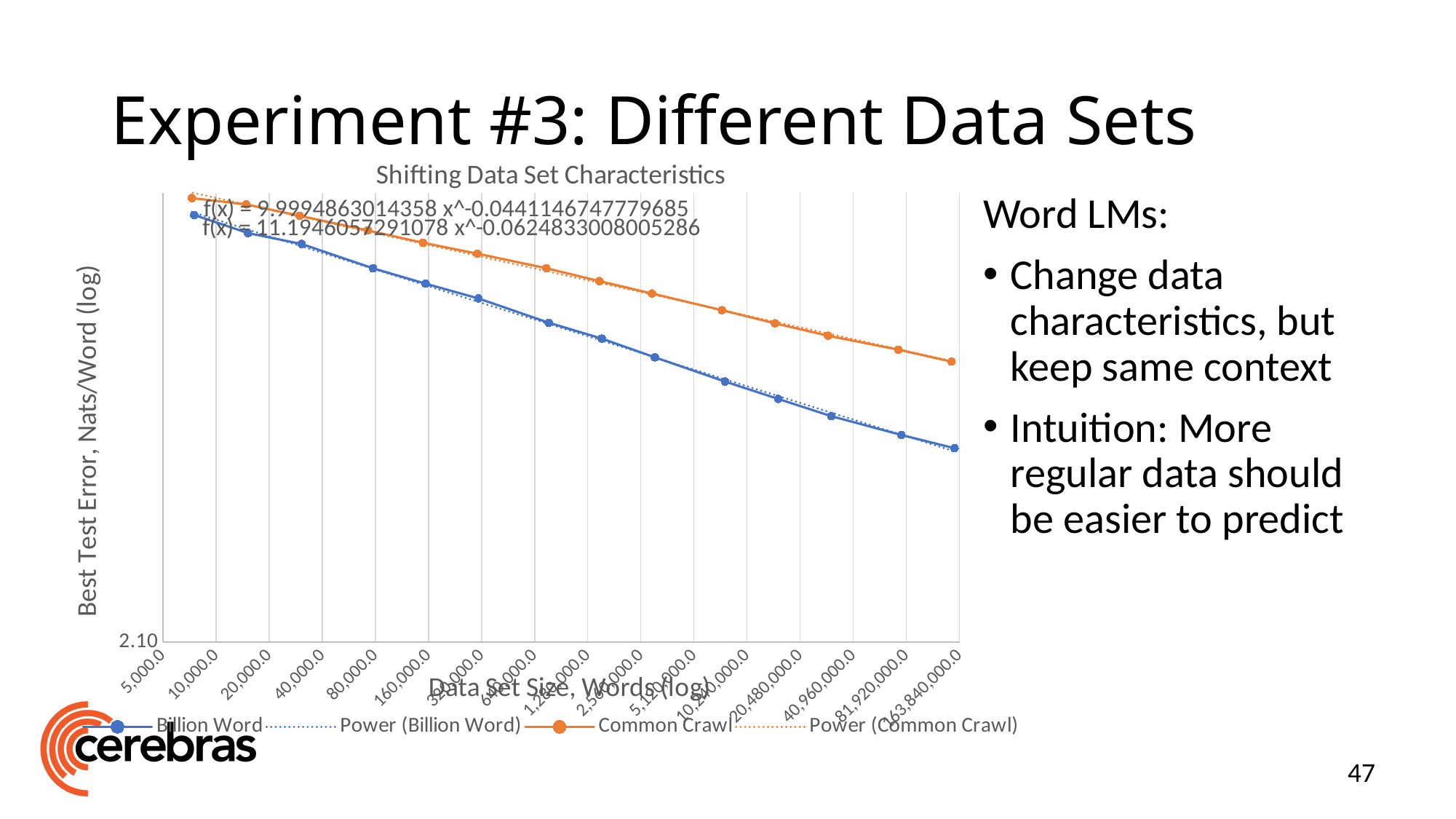
What is the label of the y axis? Best Test Error, Nats/Word (log) Which series declines more steeply across the x axis, Billion Word or Common Crawl? Billion Word Which series has the higher test error at a data set size of 5,000.0: Billion Word or Common Crawl? Common Crawl What is the title of the chart? Shifting Data Set Characteristics Do the Billion Word values rise or fall as data set size increases? fall What is the smallest data set size shown on the x axis? 5,000.0 Which series is plotted in orange? Common Crawl How many entries does the chart legend list? 4 What type of chart is shown on the slide? line chart Do the Common Crawl values rise or fall as data set size increases? fall How many data set size ticks are shown on the x axis? 16 Which series has the higher test error at a data set size of 163,840,000.0: Billion Word or Common Crawl? Common Crawl